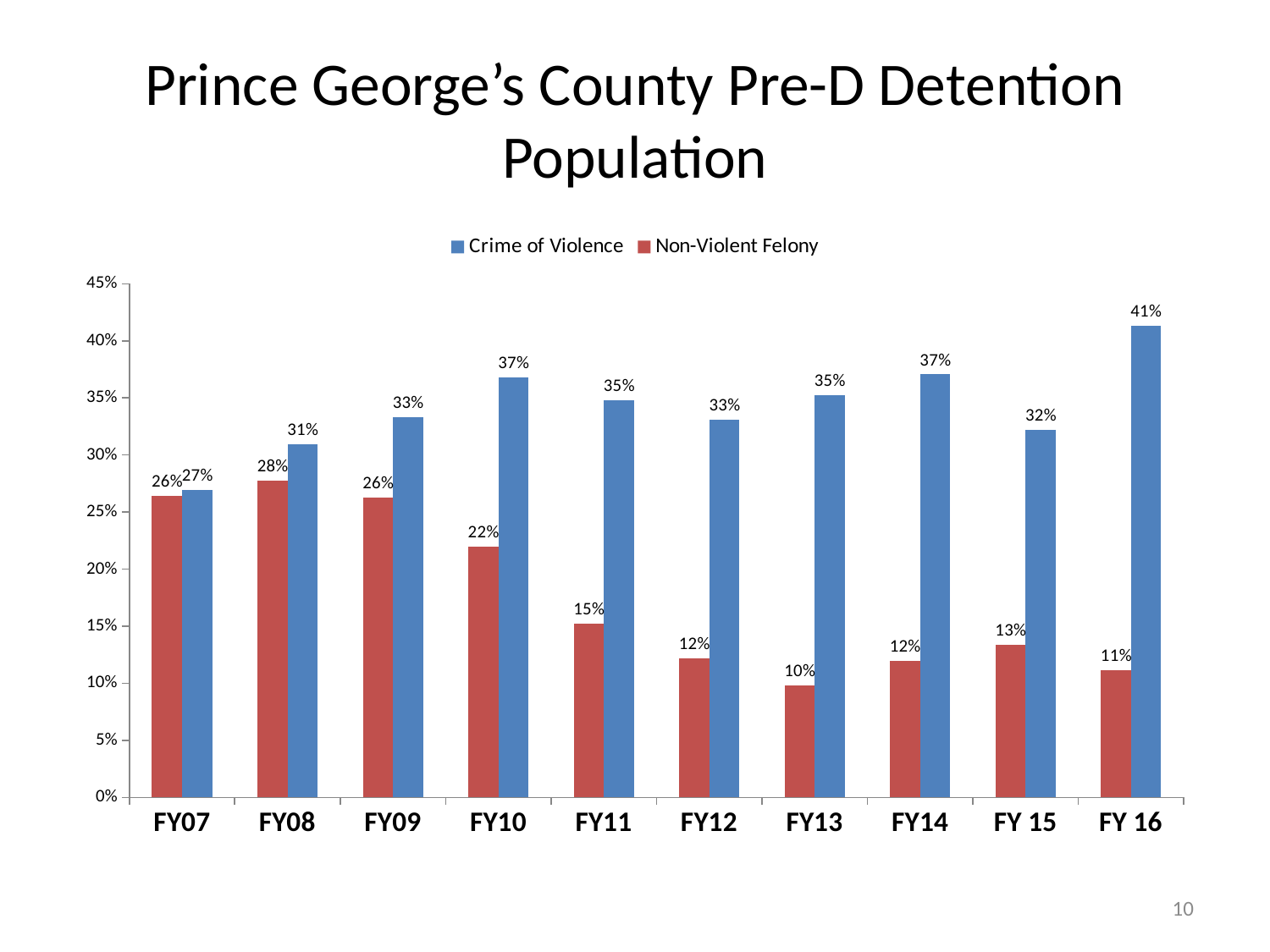
Which fiscal year has the lowest Non-Violent Felony value? FY13 What colour represents the Crime of Violence series? Blue How many series does the legend list? 2 Which is larger in FY08, Crime of Violence or Non-Violent Felony? Crime of Violence Does the Non-Violent Felony series generally rise or fall from FY07 to FY 16? Fall What is the Non-Violent Felony value for FY10? 22% What is the Crime of Violence value for FY 16? 41% Which fiscal year has the highest Crime of Violence value? FY 16 What kind of chart is shown on the slide? Bar chart How many fiscal years are shown on the x axis? 10 What is the difference between the Crime of Violence and Non-Violent Felony values in FY 16? 30% What is the Crime of Violence value for FY11? 35%